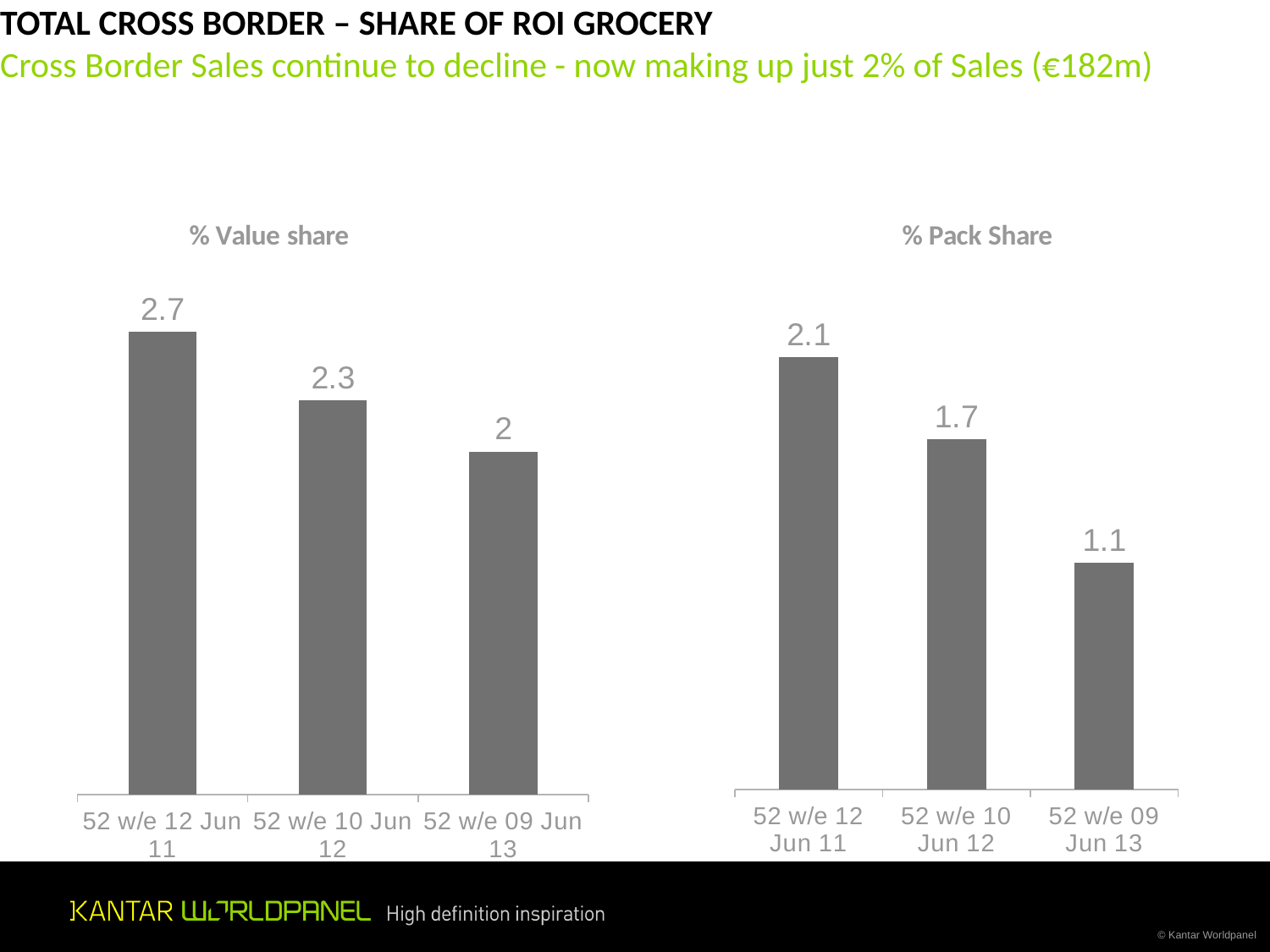
In the % Value share chart, what is the value for 52 w/e 09 Jun 13? 2 In the % Pack Share chart, which period has the lowest value? 52 w/e 09 Jun 13 Which is larger: the % Value share for 52 w/e 10 Jun 12 or the % Pack Share for 52 w/e 10 Jun 12? % Value share for 52 w/e 10 Jun 12 In the % Value share chart, what is the value for 52 w/e 12 Jun 11? 2.7 What is the title of the chart on the right side of the slide? % Pack Share In the % Value share chart, what is the difference between the values for 52 w/e 12 Jun 11 and 52 w/e 09 Jun 13? 0.7 How many bars are plotted in the % Pack Share chart? 3 In the % Value share chart, which period has the highest value? 52 w/e 12 Jun 11 What kind of chart is the % Value share chart? Bar chart In the % Pack Share chart, what is the value for 52 w/e 10 Jun 12? 1.7 In the % Pack Share chart, do the values rise or fall from left to right? Fall In the % Pack Share chart, what is the difference between the values for 52 w/e 12 Jun 11 and 52 w/e 10 Jun 12? 0.4